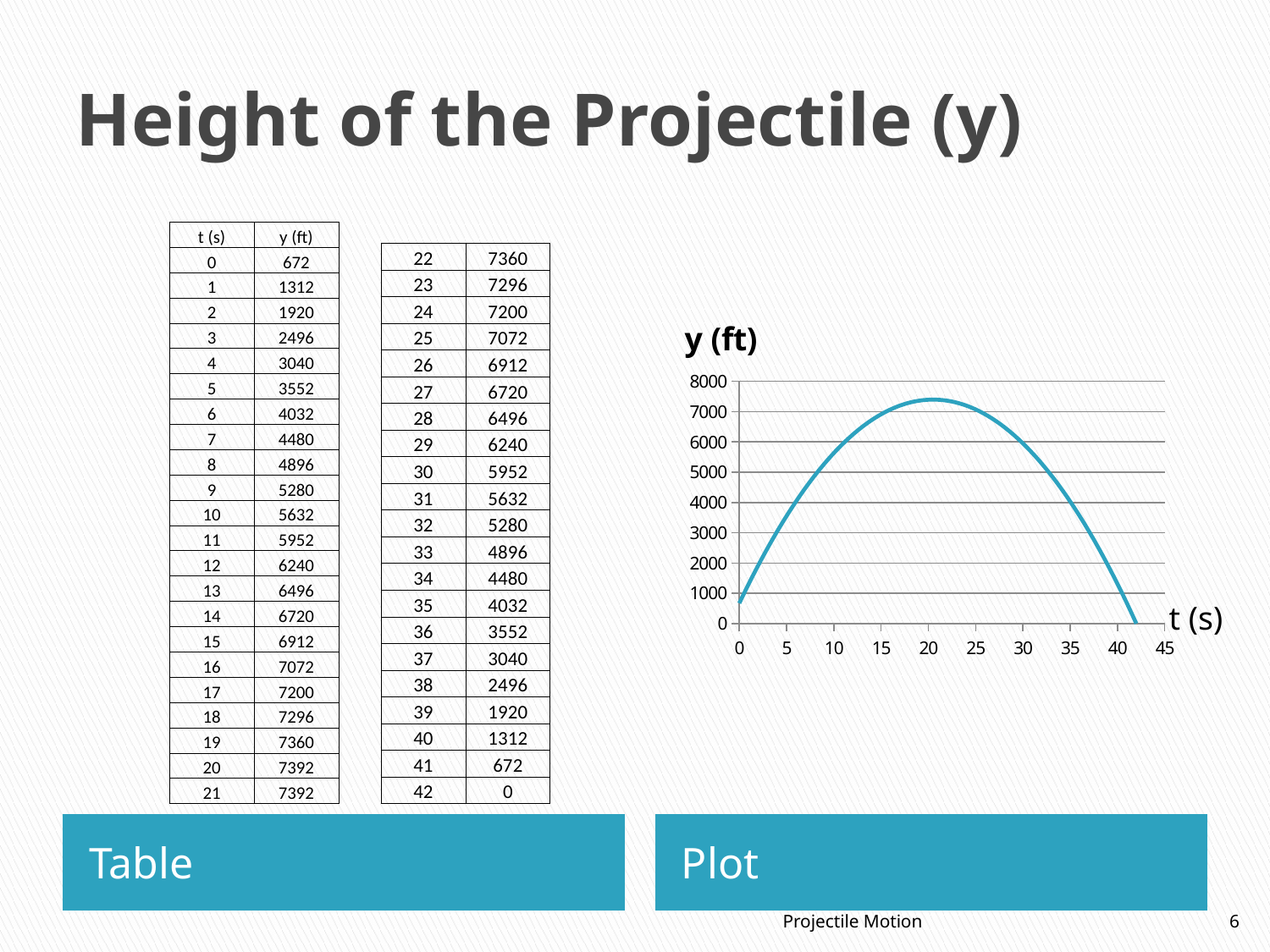
Is the value of y at t = 0 greater or less than 1000? less What is the label of the vertical axis of the plot? y (ft) Is the value of y at t = 20 greater or less than 7000? greater How does y change as t increases from 0 to 42? rises then falls Is the value of y at t = 35 greater or less than 5000? less What is the label of the horizontal axis of the plot? t (s) What is the value of y where the curve reaches the horizontal axis at t = 42? 0 Which of the two values is larger: y at t = 15 or y at t = 40? y at t = 15 What kind of chart is shown on the slide? line chart